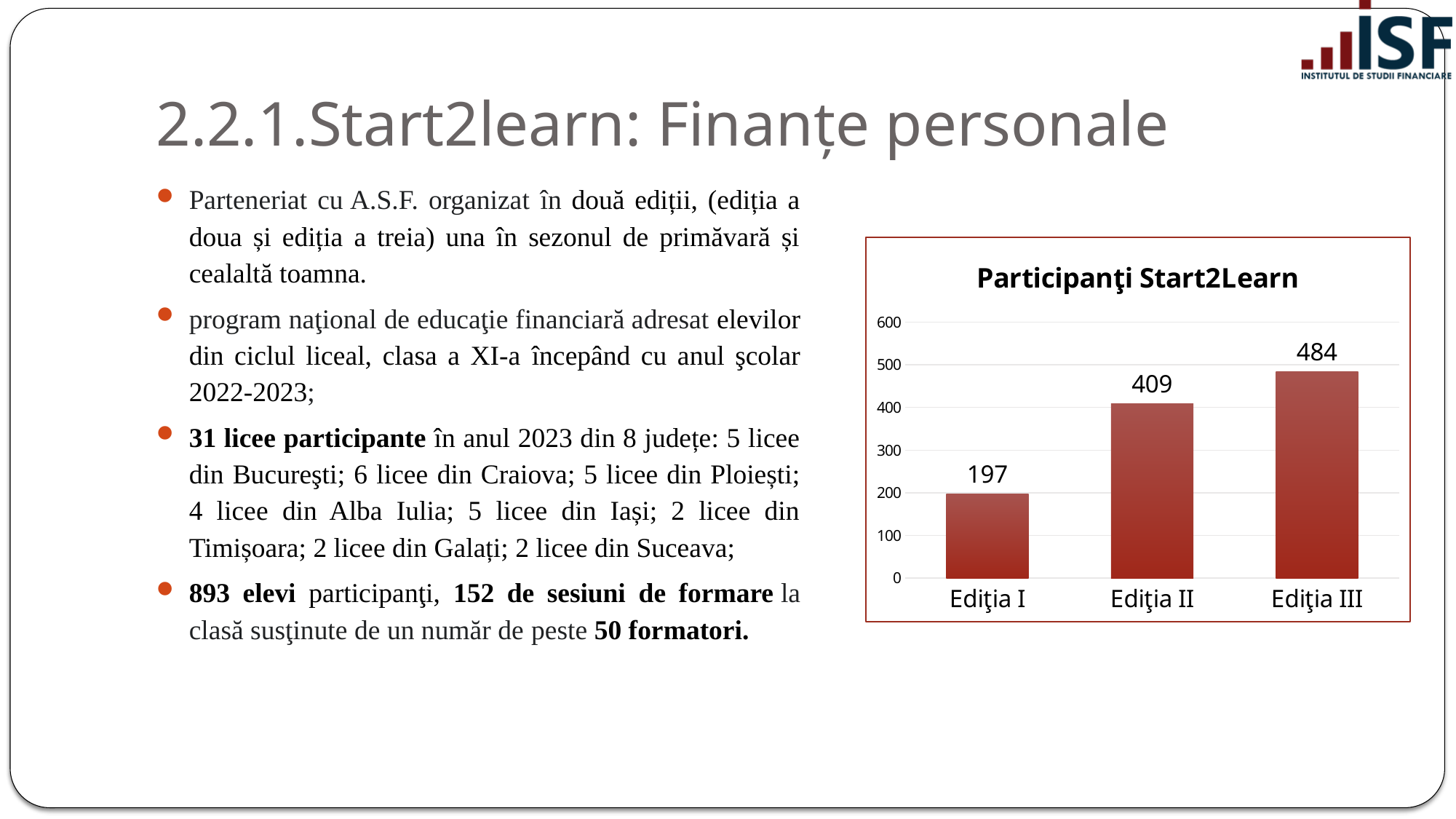
What kind of chart is shown on the slide? bar chart How many categories are shown on the x axis of the chart? 3 What is the difference between the values for Ediţia III and Ediţia II? 75 Which edition has the lowest number of participants? Ediţia I What is the value for Ediţia I? 197 What is the difference between the values for Ediţia II and Ediţia I? 212 What is the value for Ediţia III? 484 Which edition has the highest number of participants? Ediţia III Do the values rise or fall from Ediţia I to Ediţia III? rise What is the value for Ediţia II? 409 Which is larger, the value for Ediţia I or the value for Ediţia II? Ediţia II Is the value for Ediţia III greater or less than 400? greater